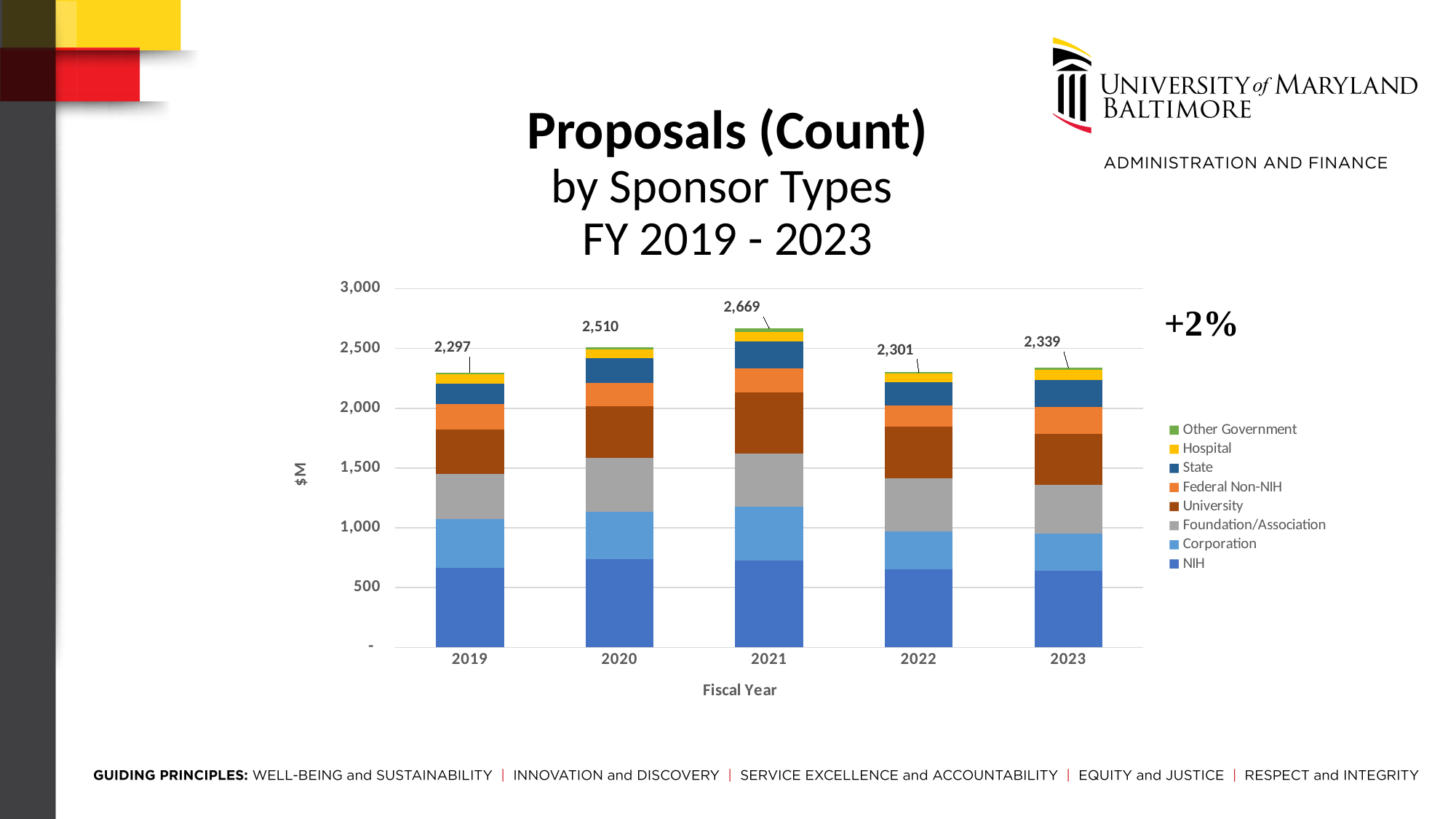
Which fiscal year has the lowest total proposal count? 2019 What is the difference between the total proposal counts for 2023 and 2022? 38 Is the NIH value for 2019 greater or less than 500? greater What is the total proposal count shown for fiscal year 2019? 2,297 What is the difference between the total proposal counts for 2021 and 2020? 159 Do the total proposal counts rise or fall from 2019 to 2021? Rise What is the total proposal count shown for fiscal year 2021? 2,669 How many sponsor types does the legend list? 8 Which fiscal year has the highest total proposal count? 2021 What kind of chart is shown on the slide? Stacked bar chart How many fiscal years are shown on the x axis? 5 Which fiscal year has a larger total proposal count, 2020 or 2022? 2020